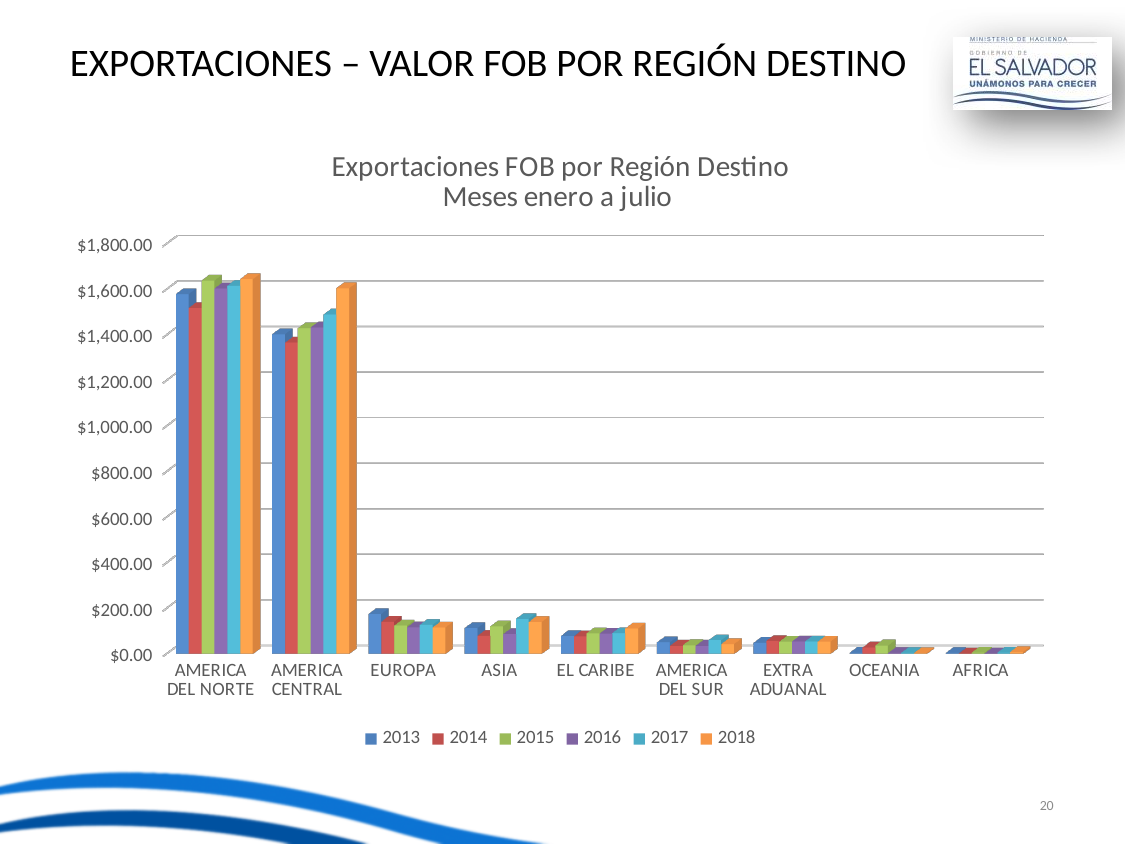
Which year is shown in orange in the chart legend? 2018 What type of chart is shown on the slide? bar chart Is the value for AMERICA CENTRAL in 2013 greater or less than $1,600.00? less Which is larger in 2018, the value for AMERICA DEL NORTE or AMERICA CENTRAL? AMERICA DEL NORTE Which region has the highest export values in the chart? AMERICA DEL NORTE Do the export values generally rise or fall moving from left to right across the regions on the x axis? fall Which region has the lowest export values in the chart? AFRICA What is the title of the chart? Exportaciones FOB por Región Destino Meses enero a julio How many destination regions are shown on the x axis of the chart? 9 How many series does the chart legend list? 6 Is the value for AMERICA DEL NORTE in 2018 greater or less than $1,400.00? greater Is the value for EUROPA in 2013 greater or less than $400.00? less